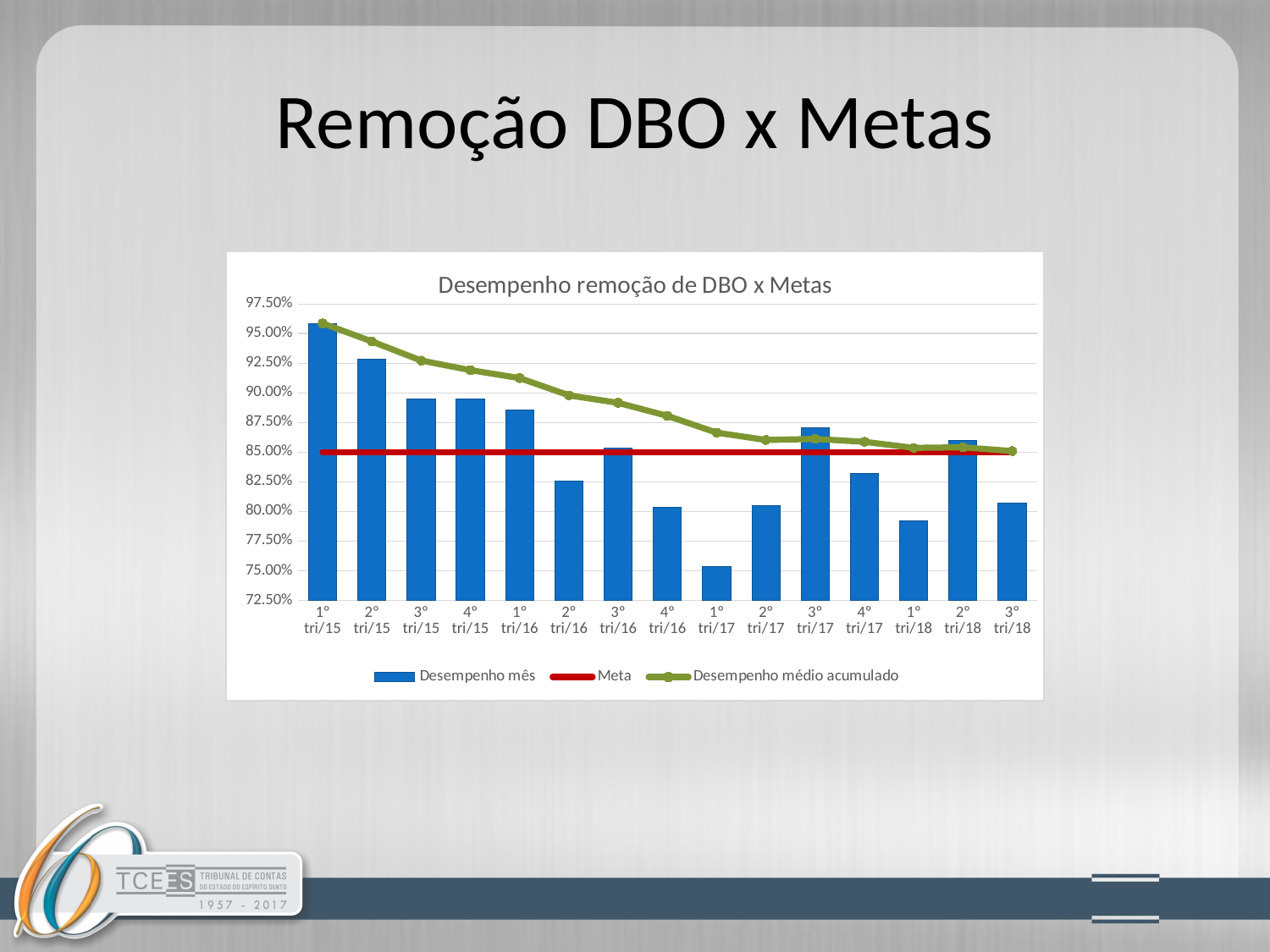
Which has the larger 'Desempenho mês' bar, 2° tri/15 or 3° tri/15? 2° tri/15 Which quarter has the highest 'Desempenho mês' bar? 1° tri/15 Does the 'Desempenho médio acumulado' line rise or fall from 1° tri/15 to 3° tri/18? fall Is the 'Desempenho mês' value for 2° tri/15 greater or less than 90.00%? greater What is the title of the chart? Desempenho remoção de DBO x Metas Is the 'Desempenho mês' value for 4° tri/17 greater or less than 85.00%? less What colour are the 'Desempenho mês' bars? Blue Is the 'Desempenho mês' value for 1° tri/17 greater or less than 77.50%? less How many quarters (categories) are shown on the x axis? 15 Which quarter has the lowest 'Desempenho mês' bar? 1° tri/17 What value does the 'Meta' line sit at? 85.00% How many series does the chart legend list? 3